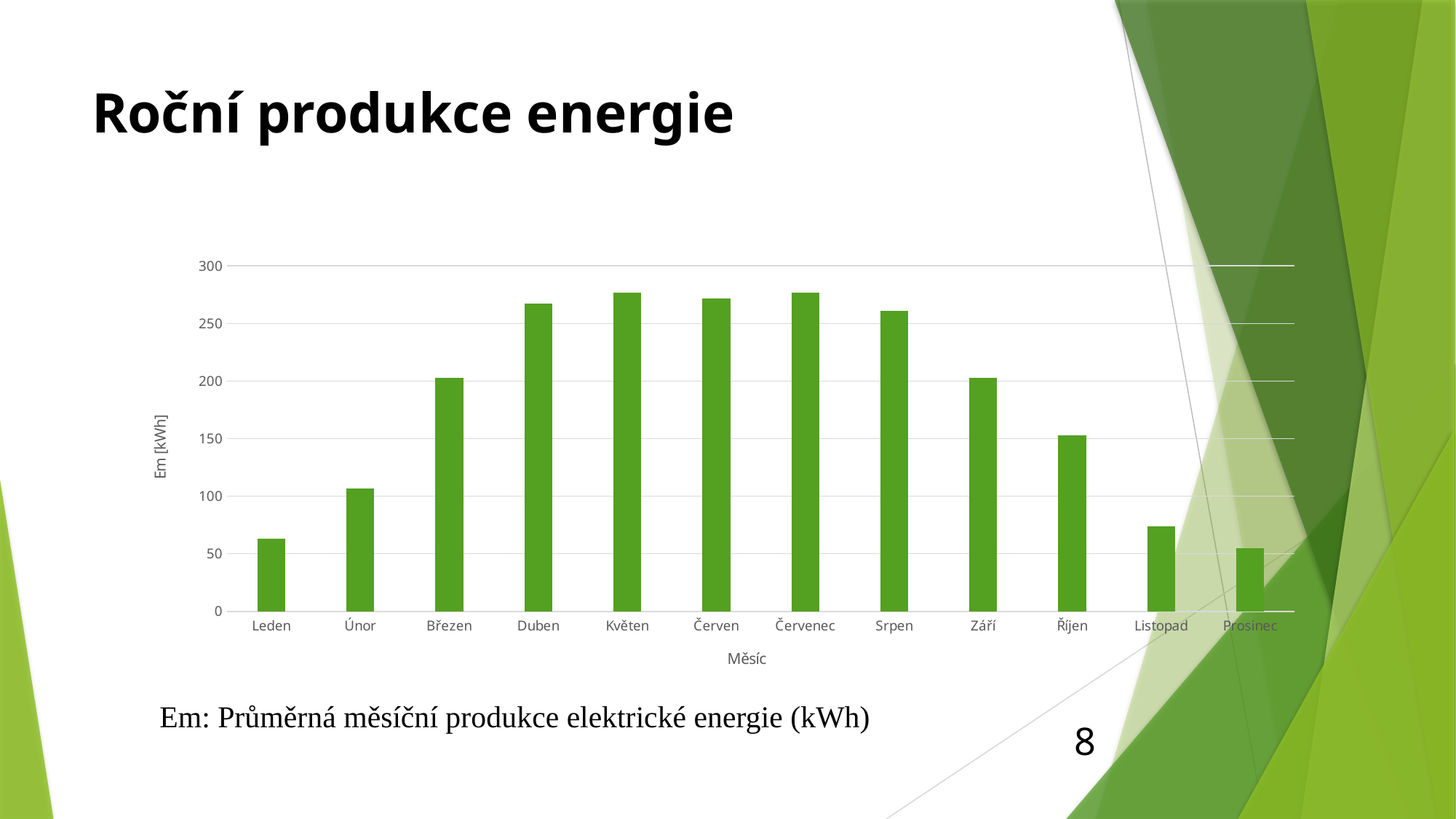
Which has the larger value, Duben or Únor? Duben Is the value for Duben greater or less than 250? greater Is the value for Říjen greater or less than 200? less How many months are shown on the x axis of the chart? 12 Do the values rise or fall from Leden to Květen? rise Is the value for Leden greater or less than 100? less What kind of chart is shown on the slide? bar chart What is the label of the vertical axis of the chart? Em [kWh] Which has the larger value, Říjen or Srpen? Srpen